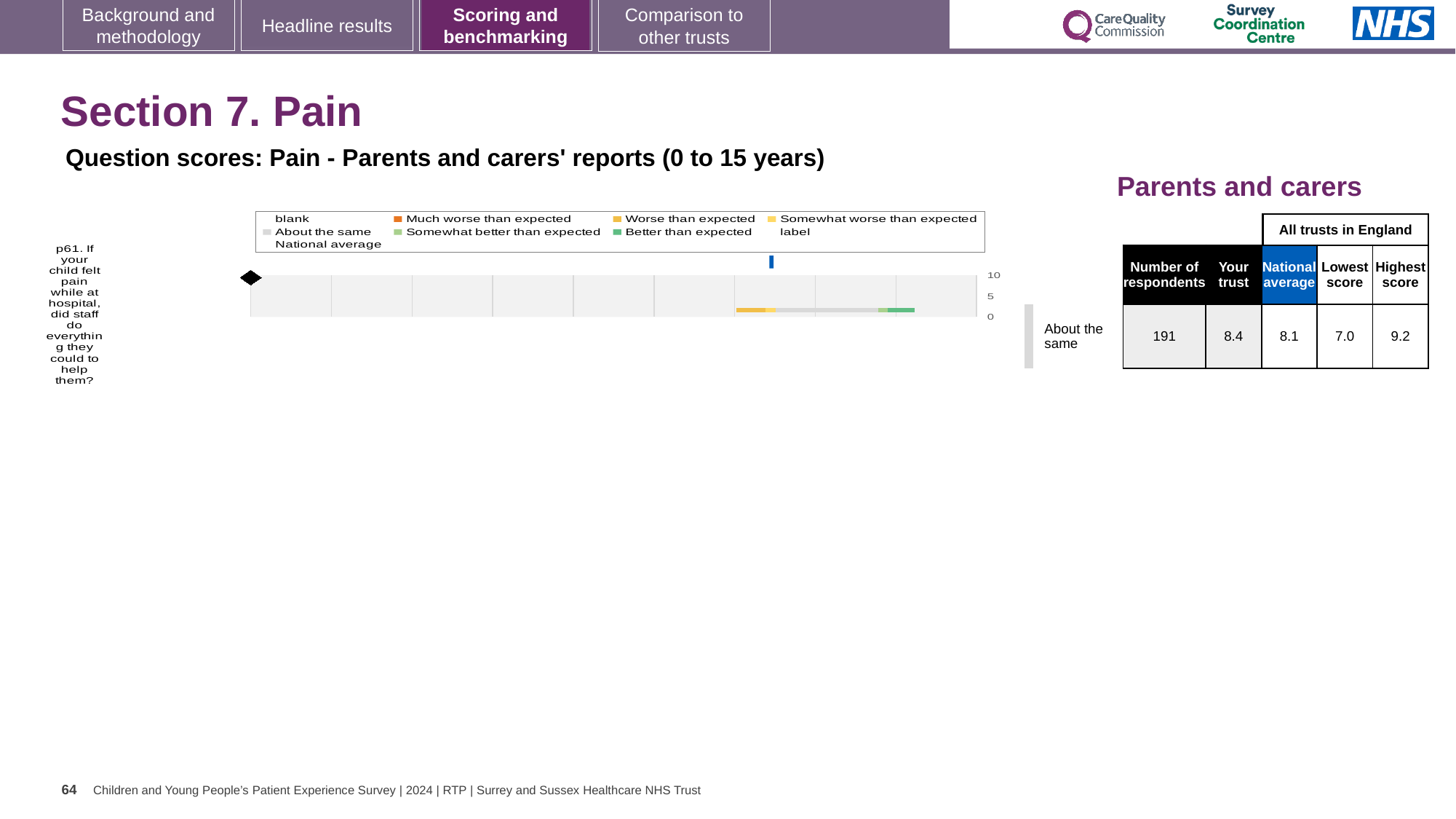
Which legend entry is shown in dark green in the chart legend? Better than expected According to the table beside the chart, what is the 'Your trust' score for question p61? 8.4 According to the table beside the chart, what is the highest score among all trusts in England for question p61? 9.2 According to the table beside the chart, what is the national average score for question p61? 8.1 What is the difference between the 'Your trust' score and the national average for question p61? 0.3 How many survey questions are plotted in the chart? 1 What is the difference between the highest score and the lowest score for question p61 in the table beside the chart? 2.2 Which is larger for question p61: the 'Your trust' score or the national average? Your trust According to the table beside the chart, what is the lowest score among all trusts in England for question p61? 7.0 What kind of chart is shown on the slide for question p61? bar chart How many respondents answered question p61, according to the table beside the chart? 191 What is the highest tick value shown on the chart's score axis? 10